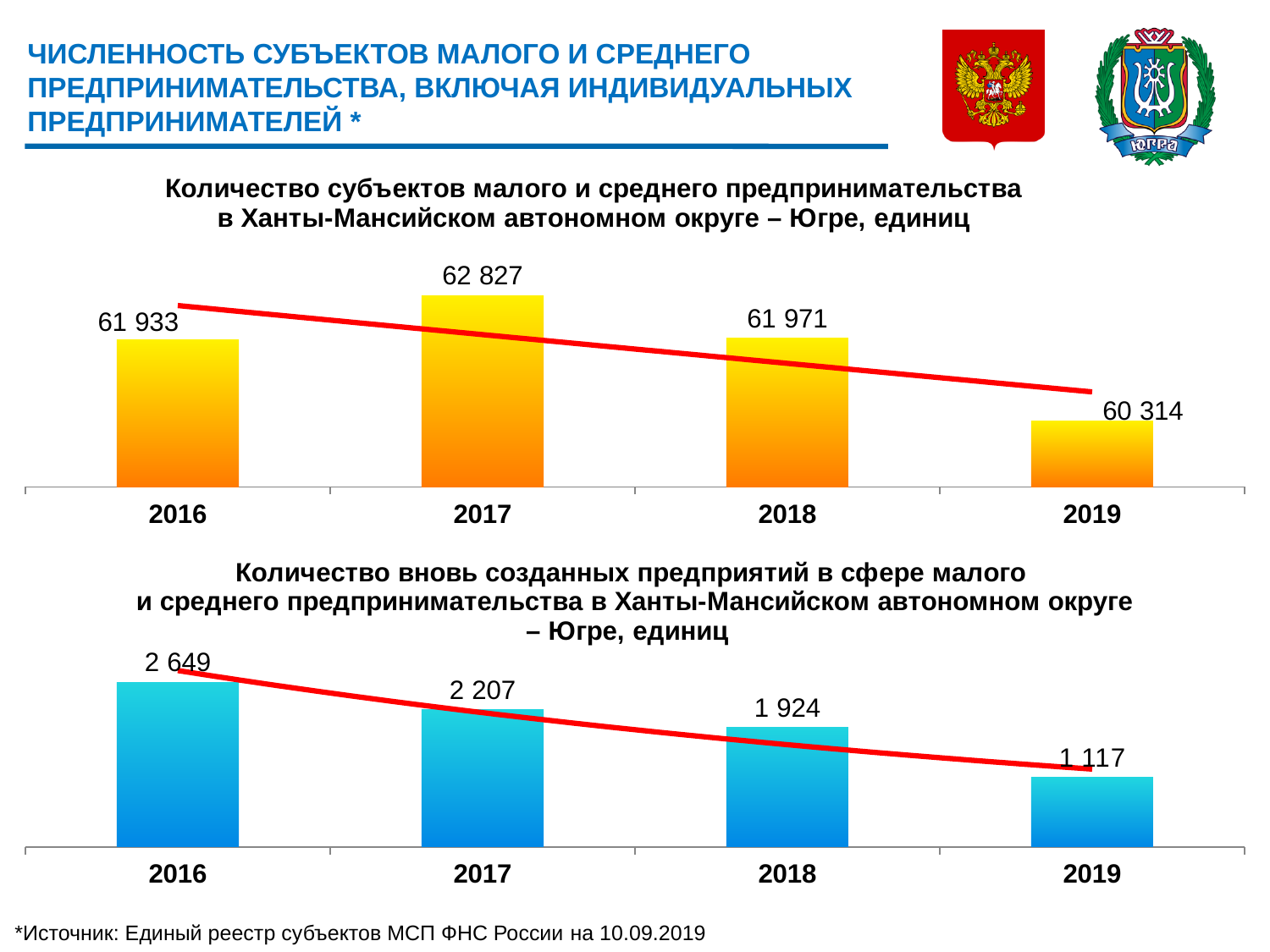
What type of chart is the top chart? bar chart In the top chart, what is the value for 2019? 60 314 In the bottom chart, what is the value for 2018? 1 924 In the top chart, which year has the lowest value? 2019 In the top chart, which year has the highest value? 2017 In the top chart, what is the number of SME subjects in 2017? 62 827 In the bottom chart, what is the number of newly created enterprises in 2016? 2 649 In the bottom chart, what is the difference between the 2016 and 2019 values? 1 532 In the bottom chart, which year has the lowest value? 2019 How many years are shown in the bottom chart? 4 In the bottom chart, do the values rise or fall from 2016 to 2019? fall In the top chart, what is the difference between the 2017 and 2019 values? 2 513